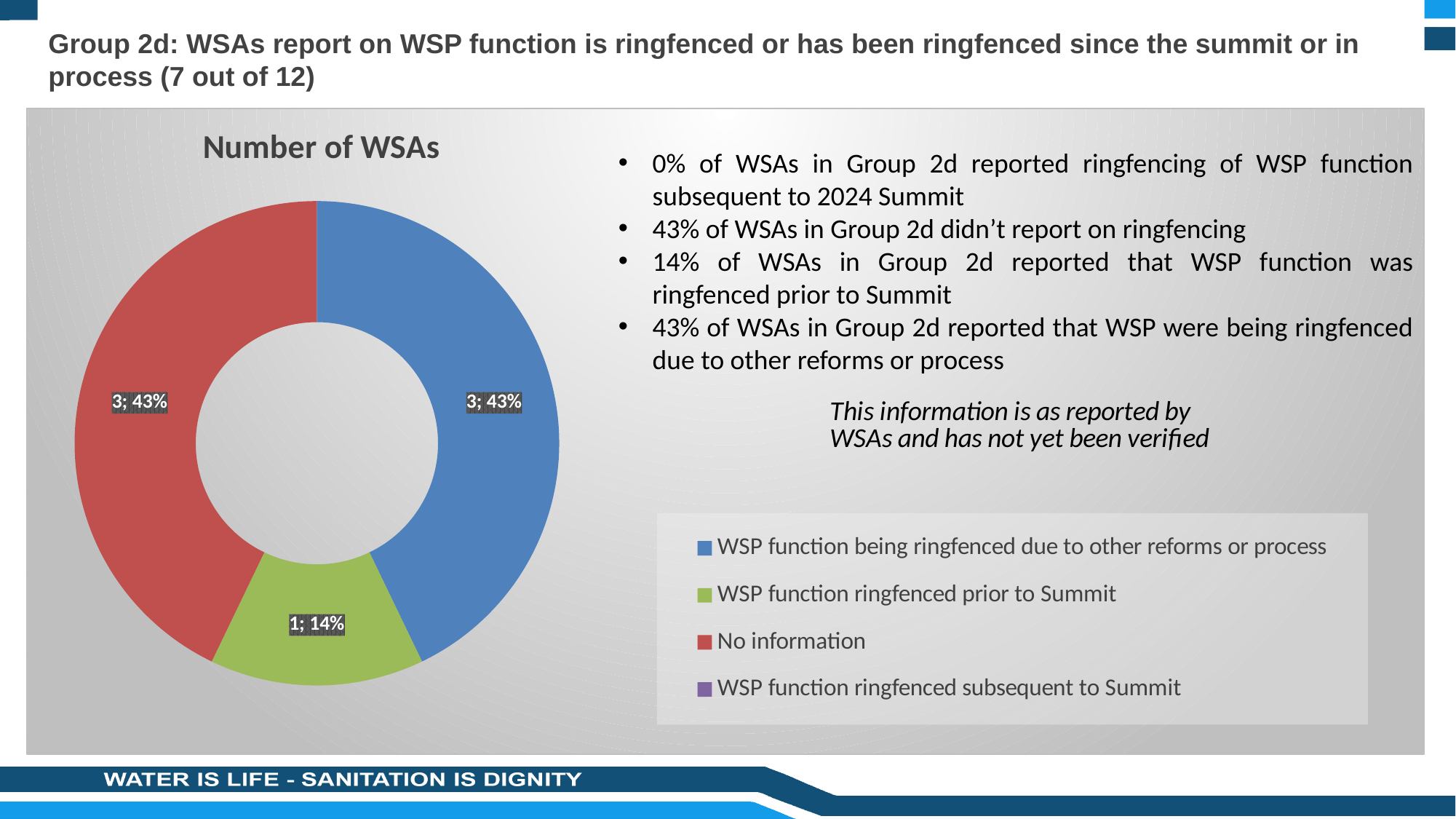
How many WSAs are in the 'WSP function ringfenced prior to Summit' category? 1 What is the total number of WSAs shown across the labelled slices of the chart? 7 What share of the chart does 'No information' represent? 43% What share of the chart does 'WSP function ringfenced prior to Summit' represent? 14% How many WSAs are in the 'WSP function being ringfenced due to other reforms or process' category? 3 What is the title of the chart? Number of WSAs Which is larger: the 'No information' slice or the 'WSP function ringfenced prior to Summit' slice? No information How many WSAs are in the 'No information' category? 3 How many entries does the chart legend list? 4 Which colour represents 'No information' in the chart? Red What is the difference in number of WSAs between 'No information' and 'WSP function ringfenced prior to Summit'? 2 What type of chart is shown on the slide? Doughnut chart